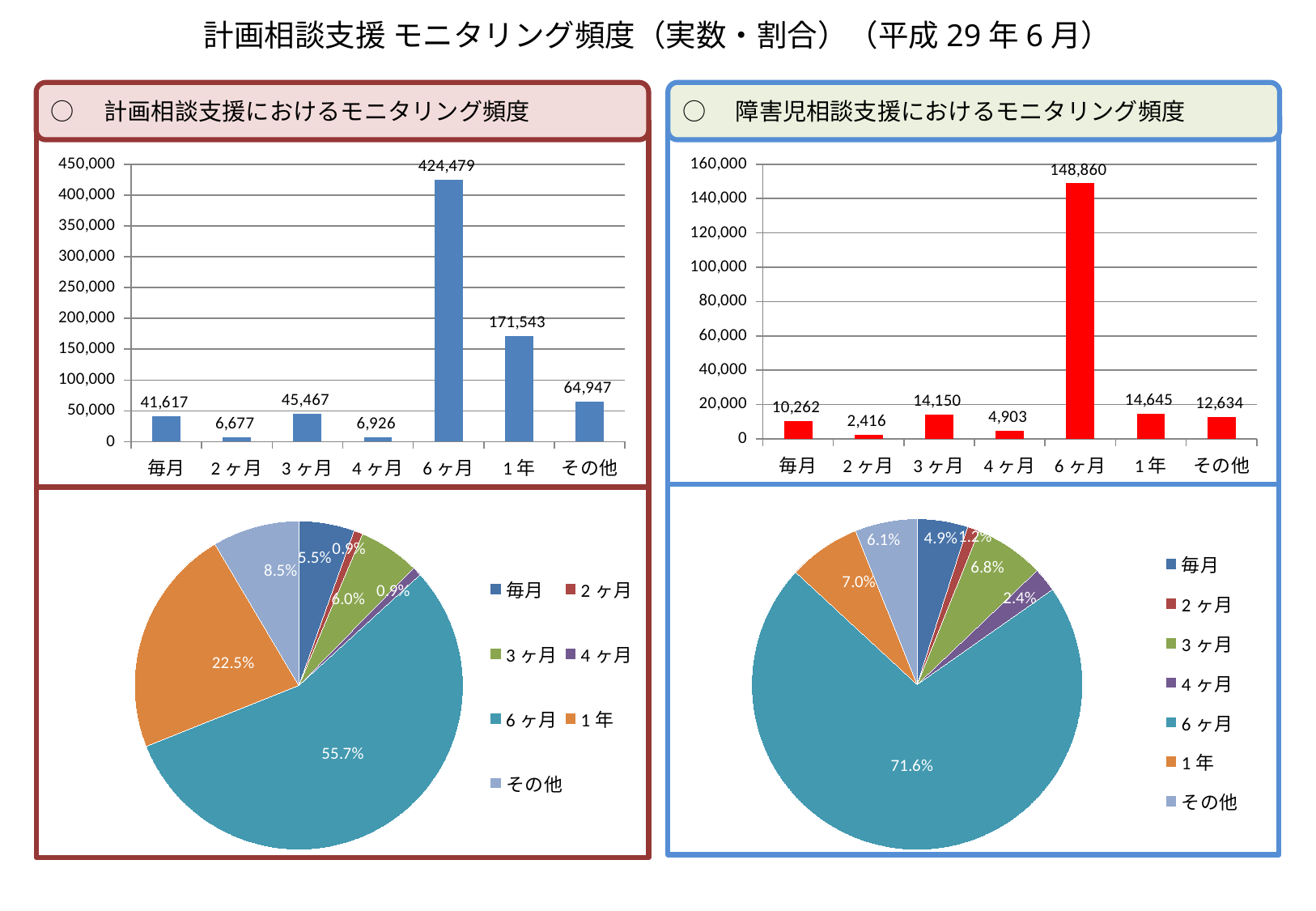
In the top-left bar chart (計画相談支援におけるモニタリング頻度), what is the value for 6ヶ月? 424,479 In the bottom-left pie chart (計画相談支援におけるモニタリング頻度), what share does 1年 have? 22.5% In the top-right bar chart (障害児相談支援におけるモニタリング頻度), which is larger, the value for 毎月 or the value for その他? その他 What kind of chart is shown in the top-right panel (障害児相談支援におけるモニタリング頻度)? bar chart In the bottom-right pie chart (障害児相談支援におけるモニタリング頻度), what share does 6ヶ月 have? 71.6% In the top-left bar chart (計画相談支援におけるモニタリング頻度), how many categories are shown on the x axis? 7 In the top-right bar chart (障害児相談支援におけるモニタリング頻度), what is the difference between the values for 1年 and 4ヶ月? 9,742 In the top-left bar chart (計画相談支援におけるモニタリング頻度), which category has the lowest value? 2ヶ月 How many entries does the legend of the bottom-right pie chart (障害児相談支援におけるモニタリング頻度) list? 7 In the top-right bar chart (障害児相談支援におけるモニタリング頻度), what is the value for 3ヶ月? 14,150 In the top-right bar chart (障害児相談支援におけるモニタリング頻度), which category has the highest value? 6ヶ月 In the top-left bar chart (計画相談支援におけるモニタリング頻度), what is the difference between the values for 1年 and その他? 106,596